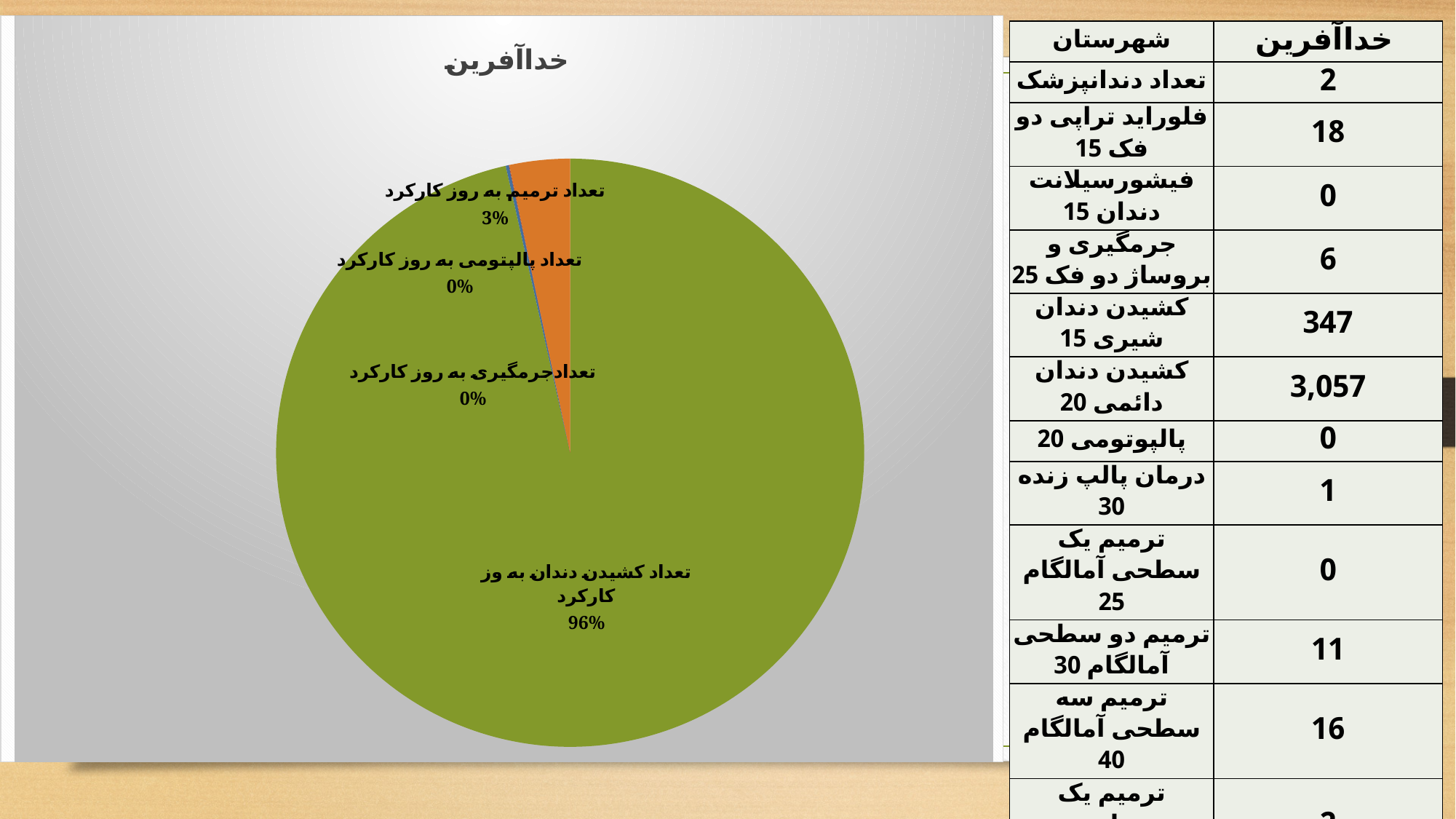
What share of the pie does تعداد ترمیم به روز کارکرد have? 3% How many categories are labelled on the pie chart? 4 What share of the pie does تعداد جرمگیری به روز کارکرد have? 0% What is the title of the pie chart? خداآفرین What share of the pie does تعداد پالپتومی به روز کارکرد have? 0% What colour is the largest slice of the pie? green What kind of chart is shown on the slide? pie chart Which is larger, the share for تعداد ترمیم به روز کارکرد or the share for تعداد کشیدن دندان به روز کارکرد? تعداد کشیدن دندان به روز کارکرد Which category has the largest slice of the pie? تعداد کشیدن دندان به روز کارکرد What is the difference in percentage points between the share for تعداد کشیدن دندان به روز کارکرد and the share for تعداد ترمیم به روز کارکرد? 93